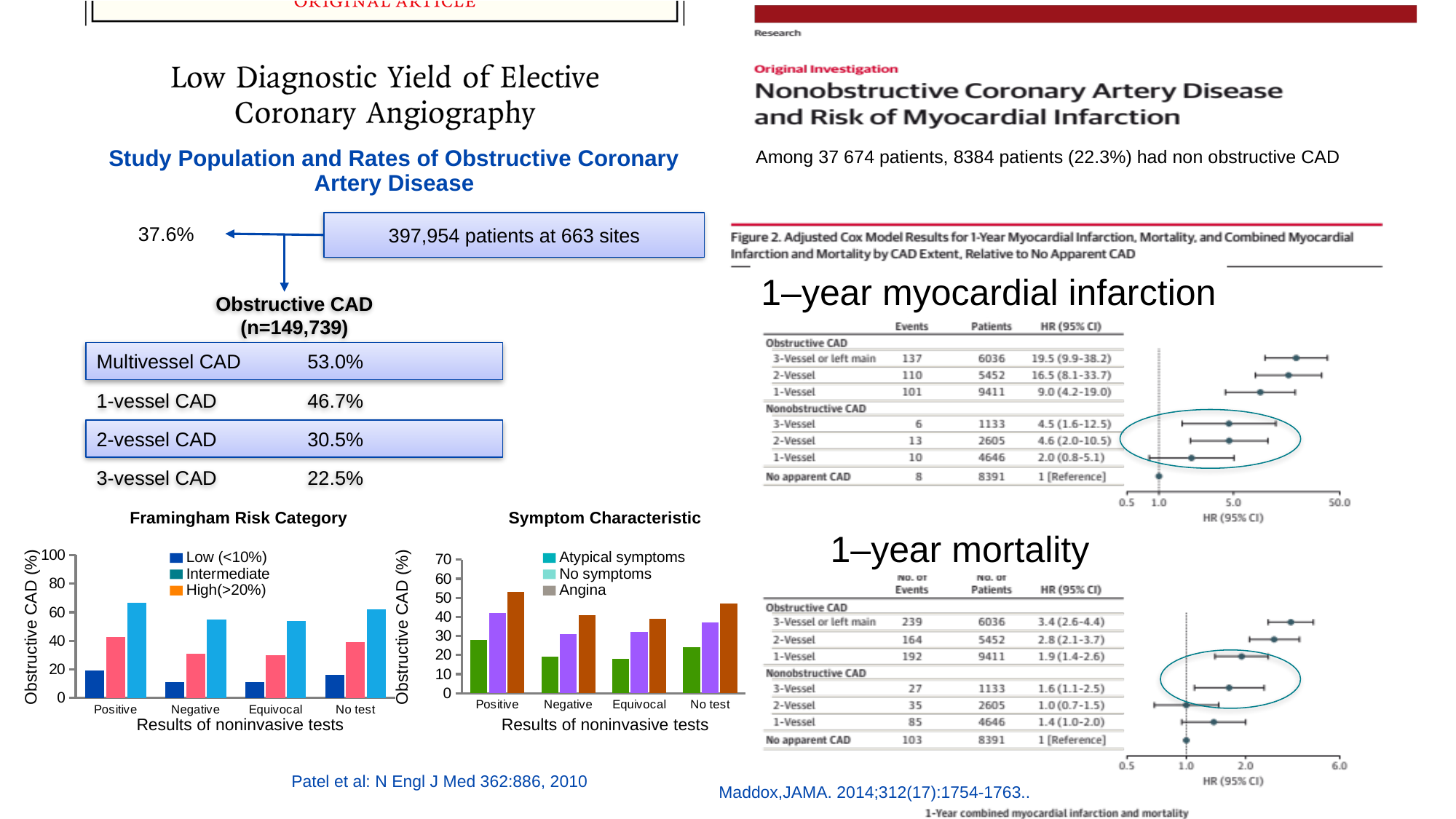
How many series does the legend of the Framingham Risk Category chart list? 3 In the Framingham Risk Category chart, is the light blue bar for Positive greater or less than 60? greater How many series does the legend of the Symptom Characteristic chart list? 3 In the Symptom Characteristic chart, which category has the tallest orange bar? Positive What kind of chart is the Framingham Risk Category chart? bar chart In the Symptom Characteristic chart, is the orange bar for Positive greater or less than 40? greater In the Framingham Risk Category chart, is the dark blue bar for Negative greater or less than 20? less In the Framingham Risk Category chart, which is larger: the pink bar for Positive or the pink bar for Negative? Positive In the Framingham Risk Category chart, which category has the tallest light blue bar? Positive How many categories are shown on the x axis of the Framingham Risk Category chart? 4 What kind of chart is the Symptom Characteristic chart? bar chart What is the y-axis label of the Framingham Risk Category chart? Obstructive CAD (%)